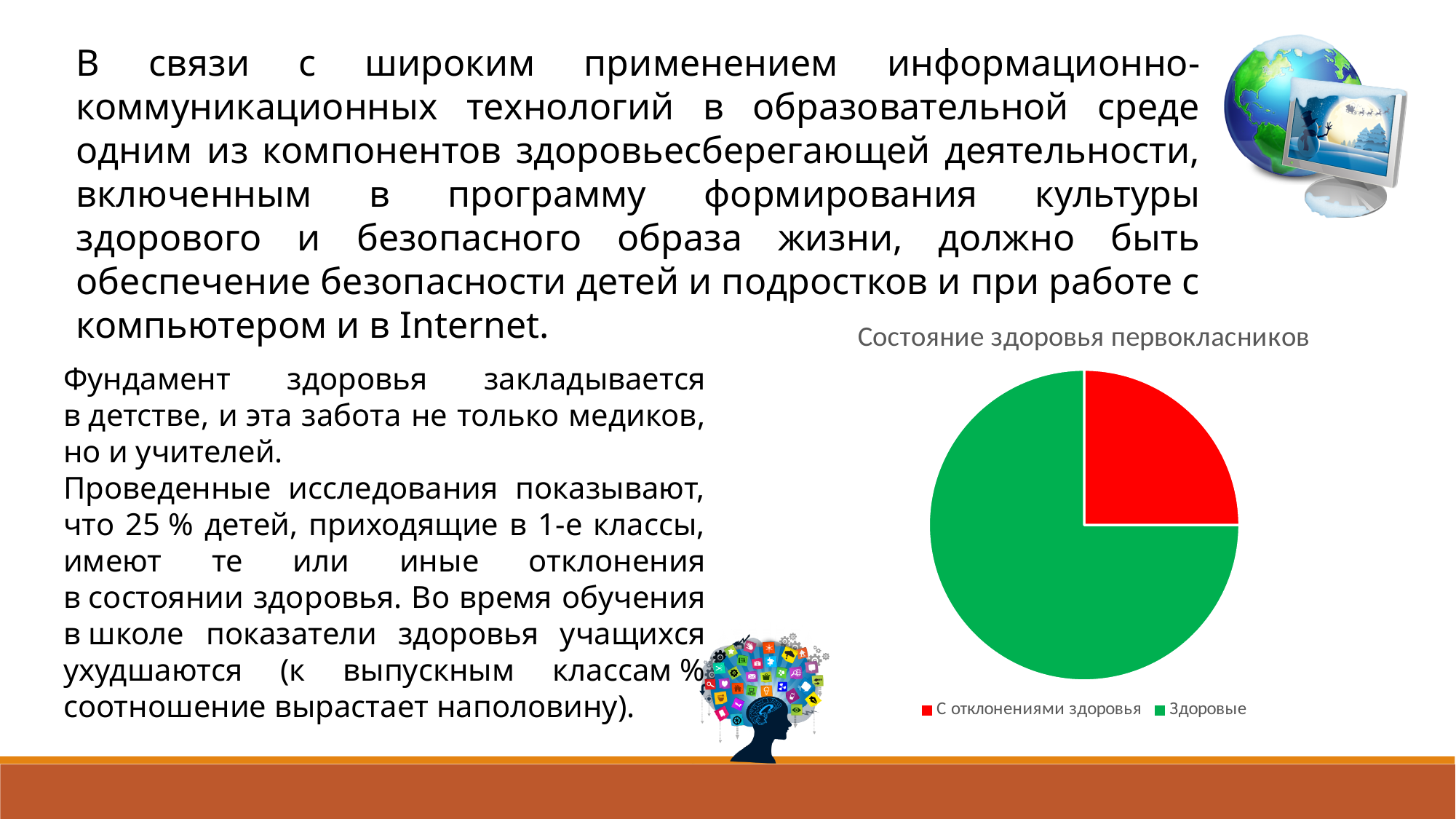
What colour is the "Здоровые" slice in the pie chart? green What kind of chart is shown on the slide? pie chart How many slices does the pie chart have? 2 How many entries does the legend of the pie chart list? 2 Which slice is larger: "С отклонениями здоровья" or "Здоровые"? Здоровые Which category has the smallest slice in the pie chart? С отклонениями здоровья What is the title of the pie chart? Состояние здоровья первокласников Which category has the largest slice in the pie chart? Здоровые